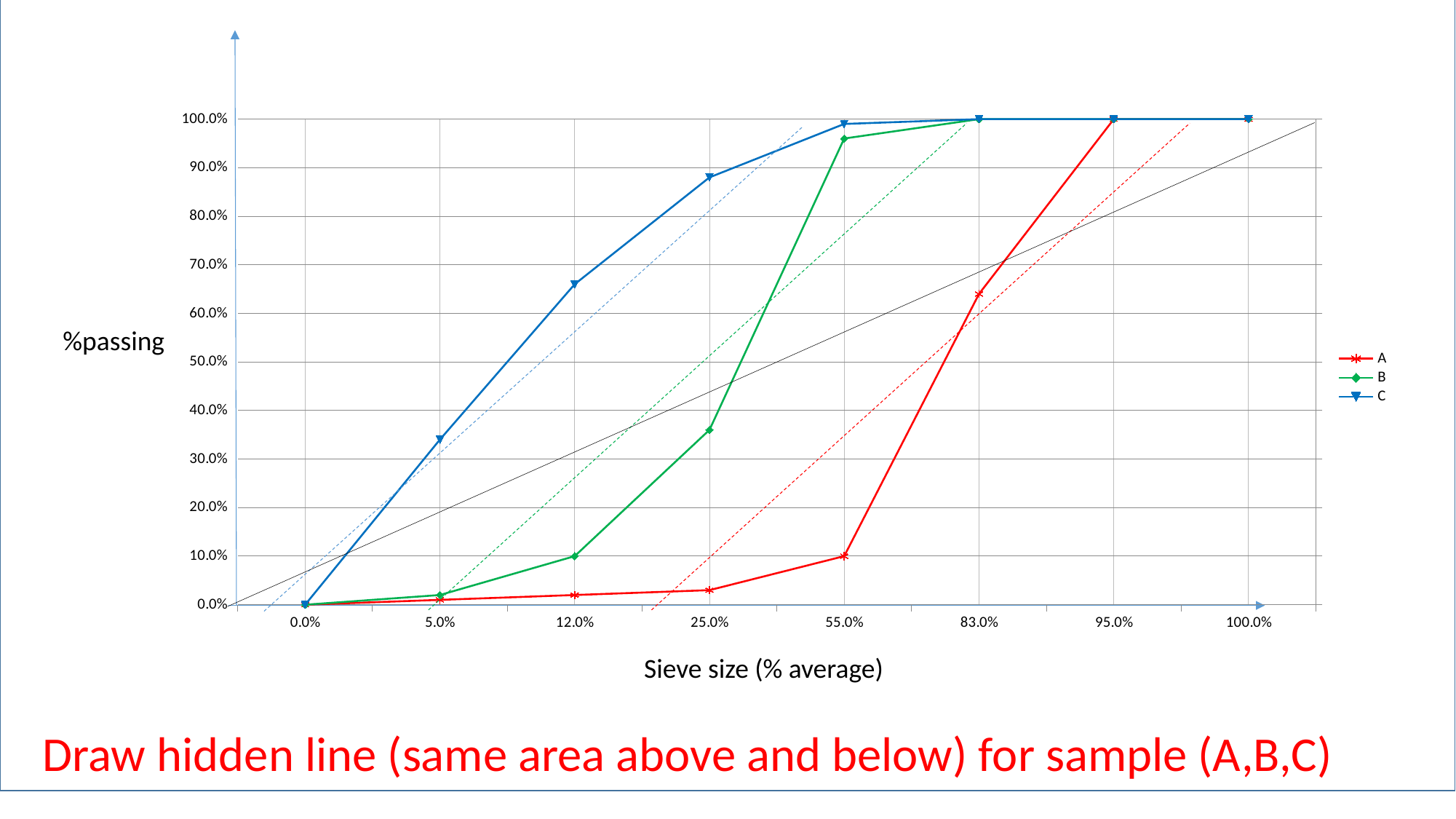
What is the value of series A at sieve size 55.0%? 10.0% What is the value of series B at sieve size 12.0%? 10.0% How many sieve size categories are shown on the x axis? 8 What is the value of series C at sieve size 83.0%? 100.0% Is the value for series A at sieve size 83.0% greater or less than 60.0%? greater Is the value for series C at sieve size 5.0% greater or less than 30.0%? greater Do the values of series A rise or fall as sieve size increases along the x axis? rise At sieve size 12.0%, which series has the larger value, B or C? C How many series does the legend list? 3 Is the value for series B at sieve size 25.0% greater or less than 30.0%? greater What kind of chart is shown on the slide? line chart What is the title of the x axis? Sieve size (% average)